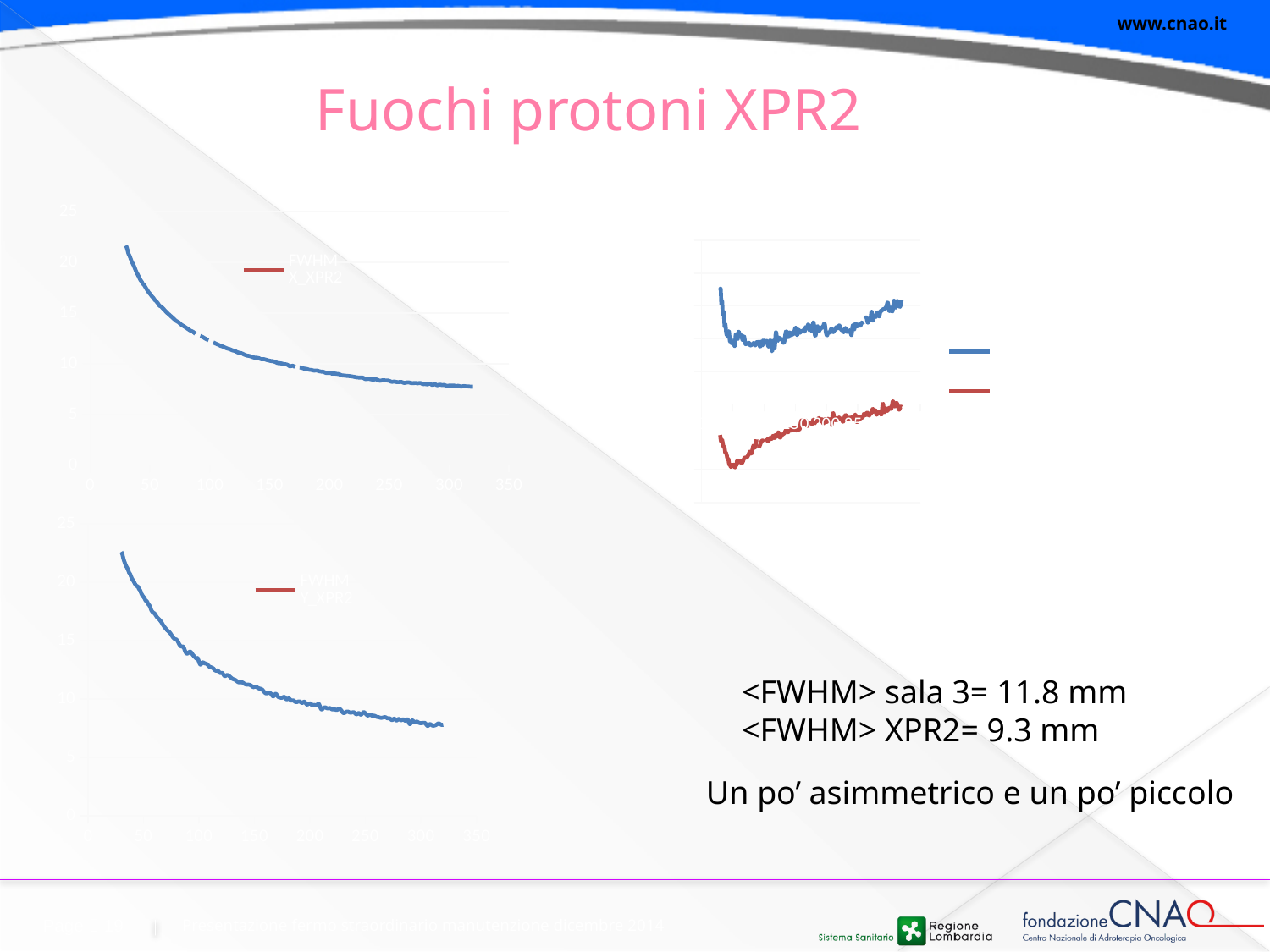
In the top-left chart (FWHM X_XPR2), is the value at x = 50 greater or less than 15? greater In the top-left chart (FWHM X_XPR2), is the value at x = 300 greater or less than 10? less What kind of chart is the top-left chart on the slide? line chart In the bottom-left chart (FWHM Y_XPR2), is the value at x = 300 greater or less than 10? less What is the legend entry of the top-left chart? FWHM X_XPR2 In the right-hand chart, which series has the higher values, the blue one or the red one? blue In the top-left chart (FWHM X_XPR2), do the values rise or fall as x increases? fall How many series does the legend of the right-hand chart list? 2 In the bottom-left chart (FWHM Y_XPR2), do the values rise or fall as x increases? fall How many charts are shown on the slide? 3 What is the legend entry of the bottom-left chart? FWHM Y_XPR2